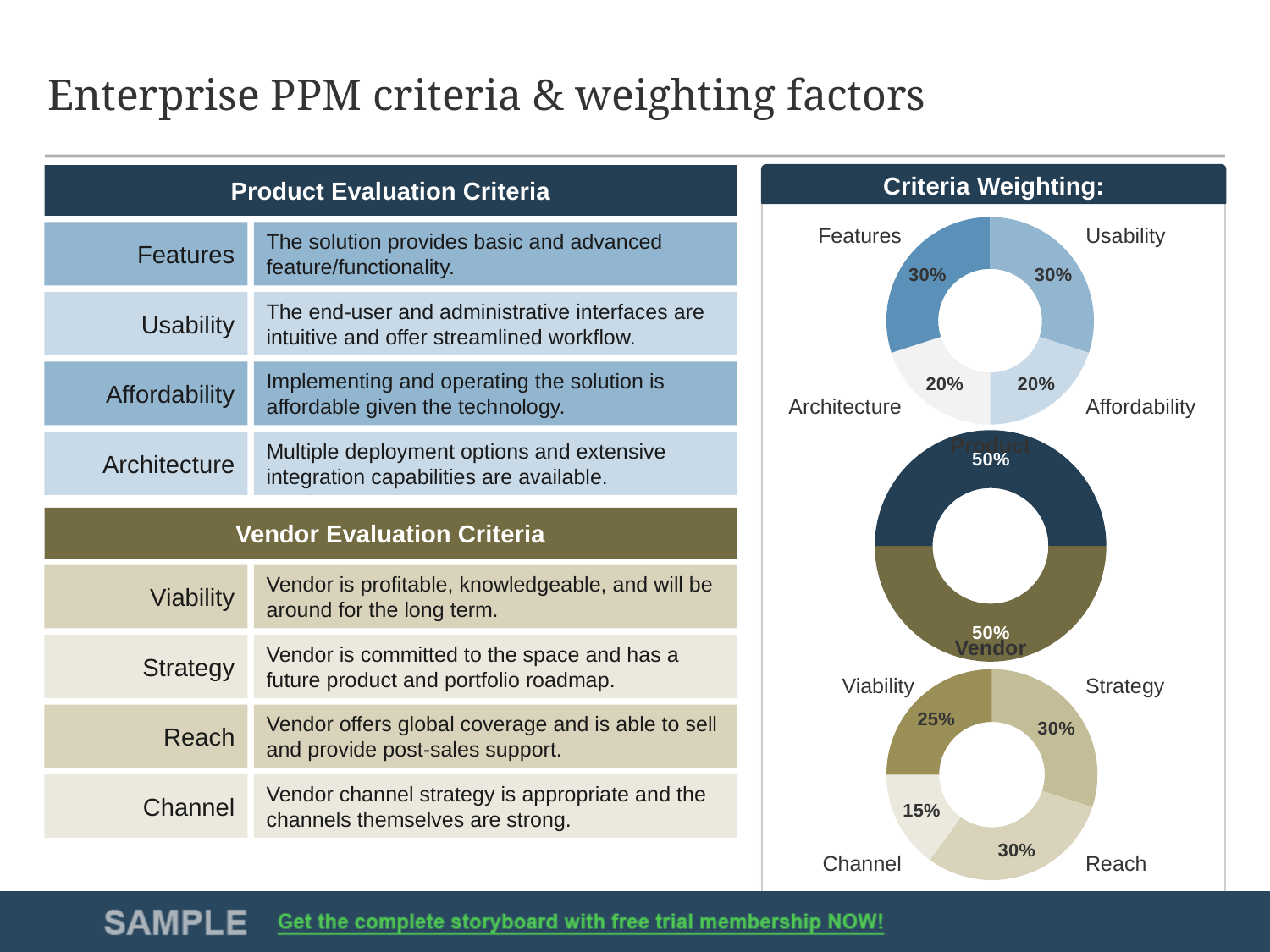
In the bottom donut chart under 'Criteria Weighting', which is larger, Reach or Viability? Reach In the bottom donut chart under 'Criteria Weighting', which category has the lowest value? Channel In the bottom donut chart under 'Criteria Weighting', what is the difference between the Strategy and Channel values? 15% What kind of chart is used for the 'Criteria Weighting' section? Donut chart In the top donut chart under 'Criteria Weighting', what is the difference between the Usability and Architecture values? 10% In the top donut chart under 'Criteria Weighting', which is larger, Features or Architecture? Features In the top donut chart under 'Criteria Weighting', what is the value for Features? 30% In the top donut chart under 'Criteria Weighting', what is the value for Affordability? 20% In the middle donut chart under 'Criteria Weighting', what is the value for Product? 50% In the top donut chart under 'Criteria Weighting', how many categories are shown? 4 In the middle donut chart under 'Criteria Weighting', how many categories are shown? 2 In the bottom donut chart under 'Criteria Weighting', what is the value for Viability? 25%